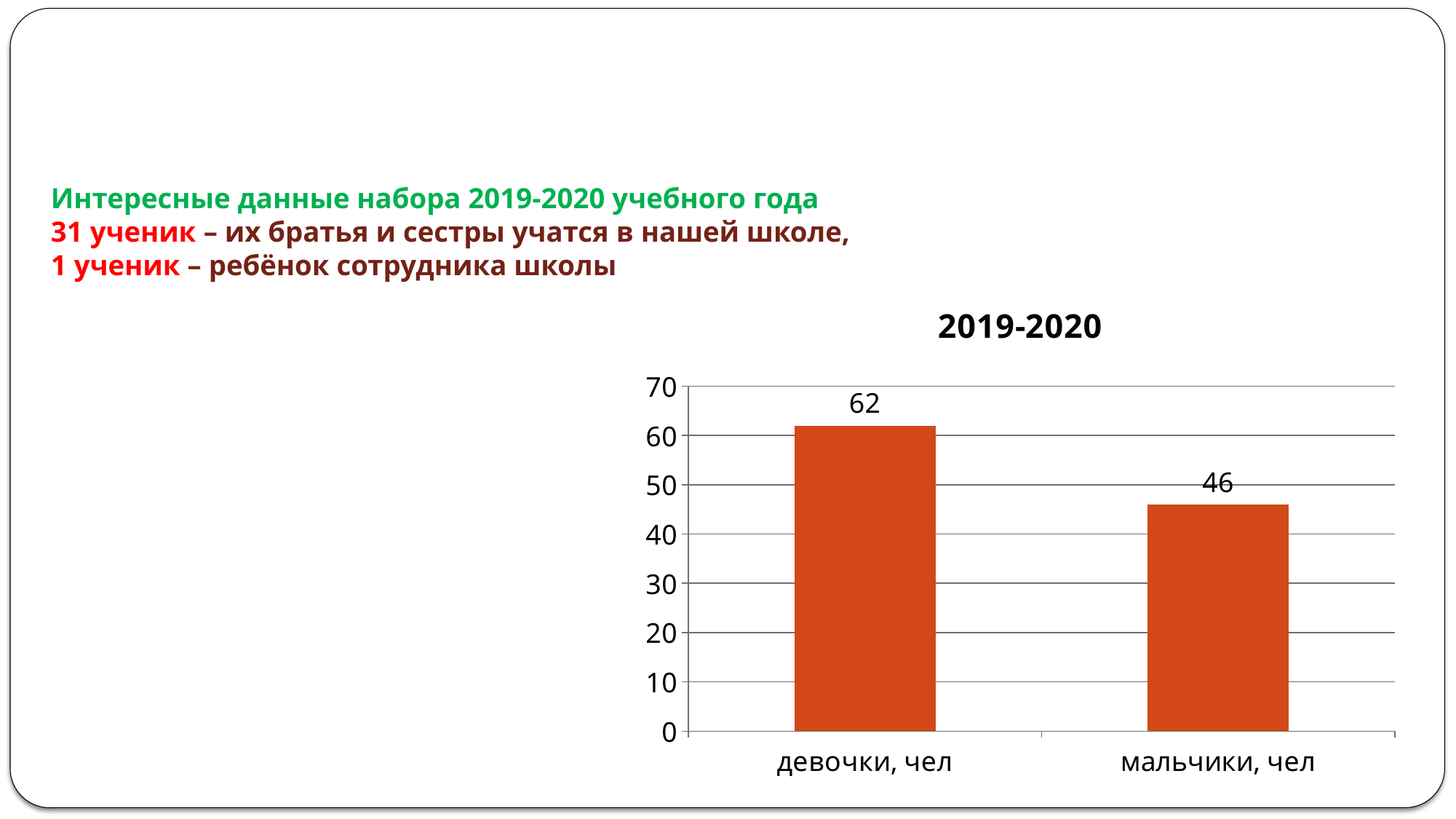
What is the difference between the values for девочки, чел and мальчики, чел? 16 What kind of chart is shown on the slide? bar chart Which category has the highest value? девочки, чел How many categories are shown on the chart? 2 Is the value for девочки, чел greater or less than 60? greater What is the title of the chart? 2019-2020 What is the highest value shown on the vertical axis? 70 Is the value for мальчики, чел greater or less than 50? less What is the value for мальчики, чел? 46 Which is larger, the value for девочки, чел or the value for мальчики, чел? девочки, чел What is the value for девочки, чел? 62 Which category has the lowest value? мальчики, чел